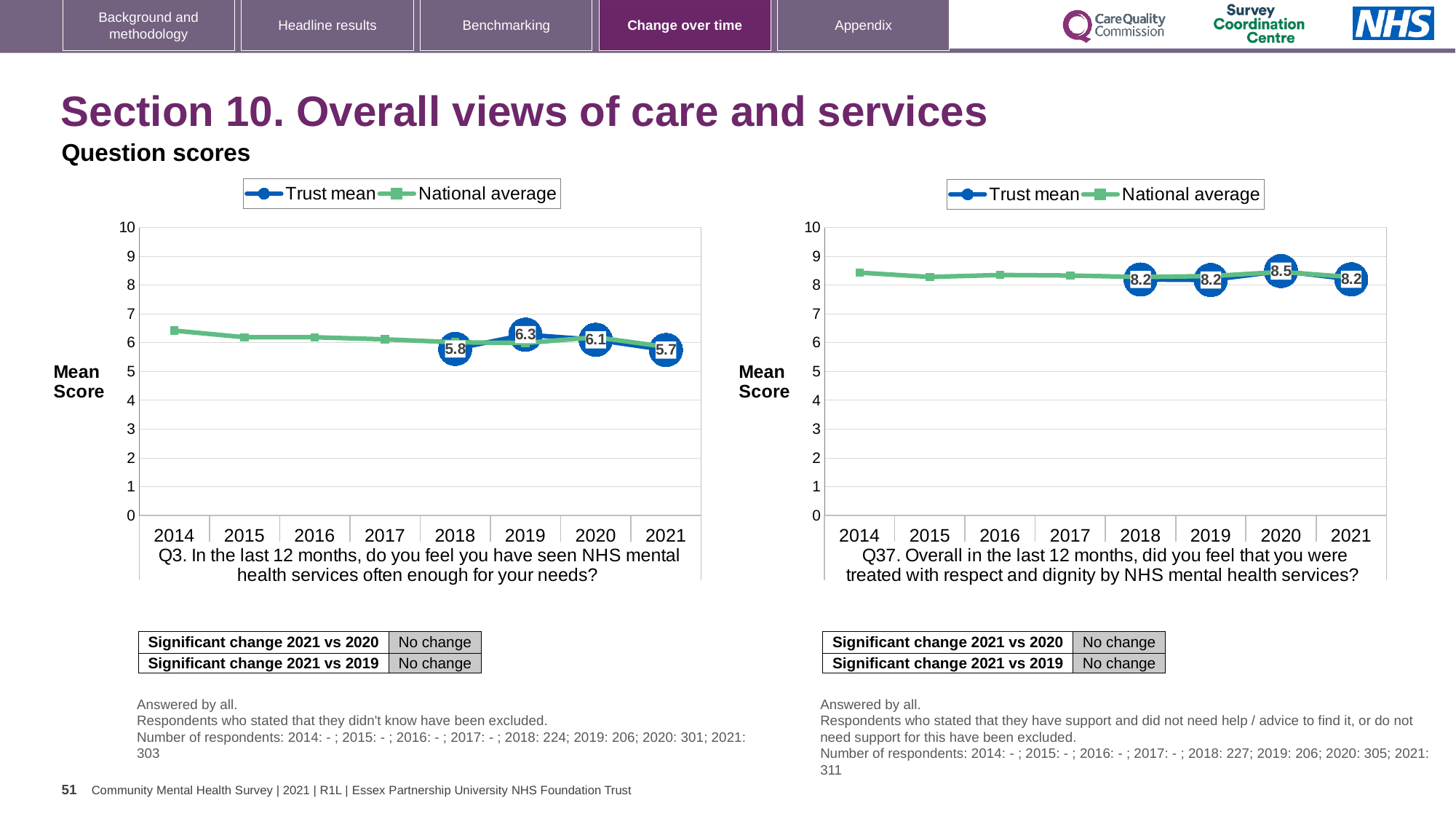
In the Q3 chart on the left, is the National average for 2014 greater or less than 6? greater In the Q37 chart on the right, is the Trust mean for 2020 greater or less than 8? greater In the Q3 chart on the left, what is the Trust mean for 2021? 5.7 In the Q3 chart on the left, which year has the highest Trust mean? 2019 In the Q37 chart on the right, what is the Trust mean for 2018? 8.2 In the Q3 chart on the left, what is the difference between the Trust mean in 2019 and in 2021? 0.6 In the Q3 chart on the left, what is the Trust mean for 2019? 6.3 What kind of chart is the Q3 chart on the left? Line chart How many series does the legend of the Q37 chart on the right list? 2 In the Q3 chart on the left, which year has the lowest Trust mean? 2021 In the Q37 chart on the right, what is the Trust mean for 2020? 8.5 In the Q37 chart on the right, which year has the highest Trust mean? 2020